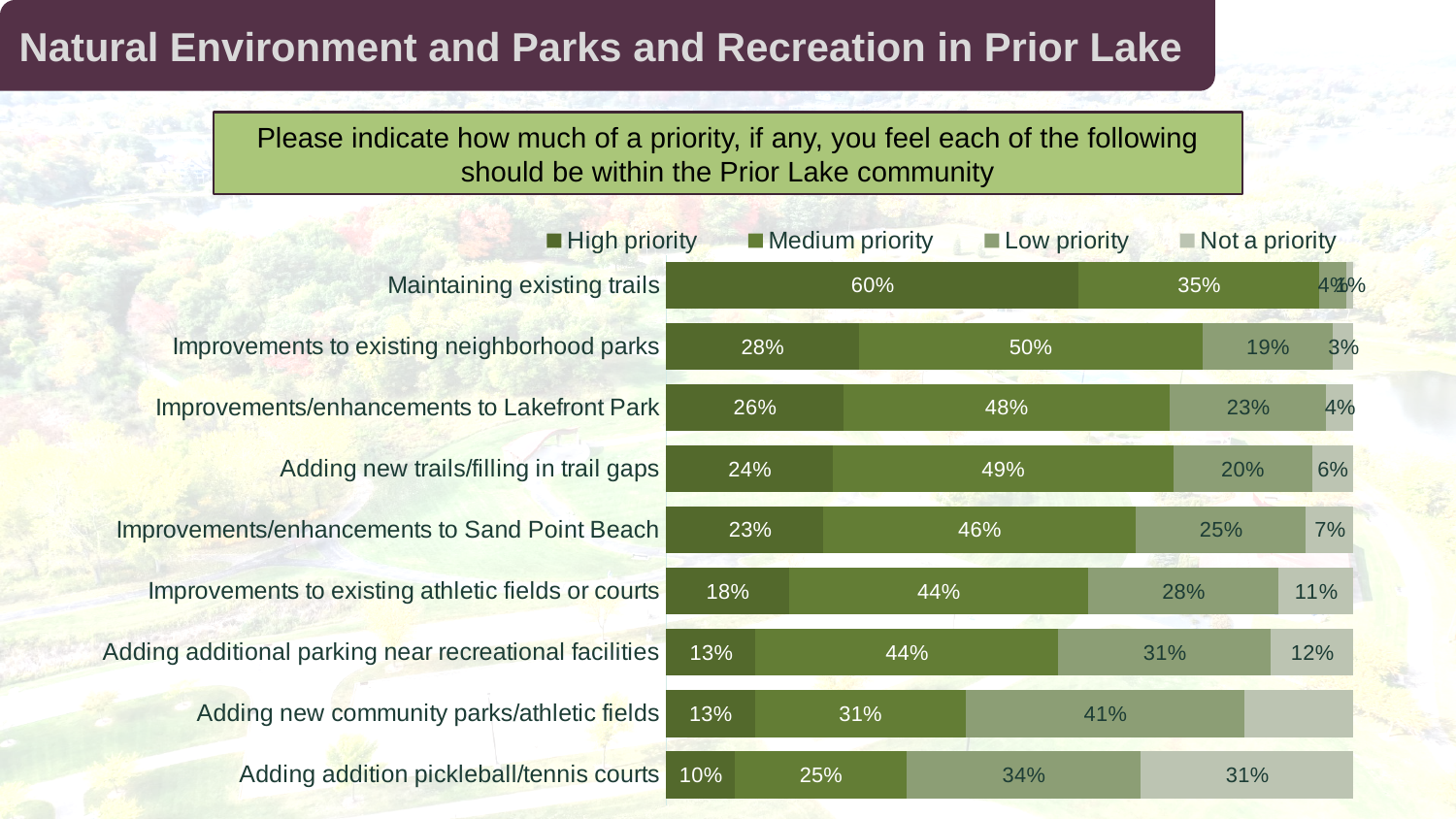
What is the 'Low priority' value for 'Improvements/enhancements to Sand Point Beach'? 25% How many series does the legend list? 4 What kind of chart is shown on the slide? Stacked bar chart Which has a larger 'Low priority' value: 'Adding additional parking near recreational facilities' or 'Improvements to existing athletic fields or courts'? Adding additional parking near recreational facilities Which item has the lowest 'High priority' percentage? Adding addition pickleball/tennis courts What is the 'Medium priority' value for 'Adding new trails/filling in trail gaps'? 49% Which item has the highest 'High priority' percentage? Maintaining existing trails What is the total of the four segments for 'Adding addition pickleball/tennis courts'? 100% What is the 'Not a priority' value for 'Adding addition pickleball/tennis courts'? 31% How many items are listed in the chart? 9 What percentage of respondents rated 'Improvements to existing neighborhood parks' as a high priority? 28% What is the difference between the 'High priority' values for 'Maintaining existing trails' and 'Improvements/enhancements to Lakefront Park'? 34%